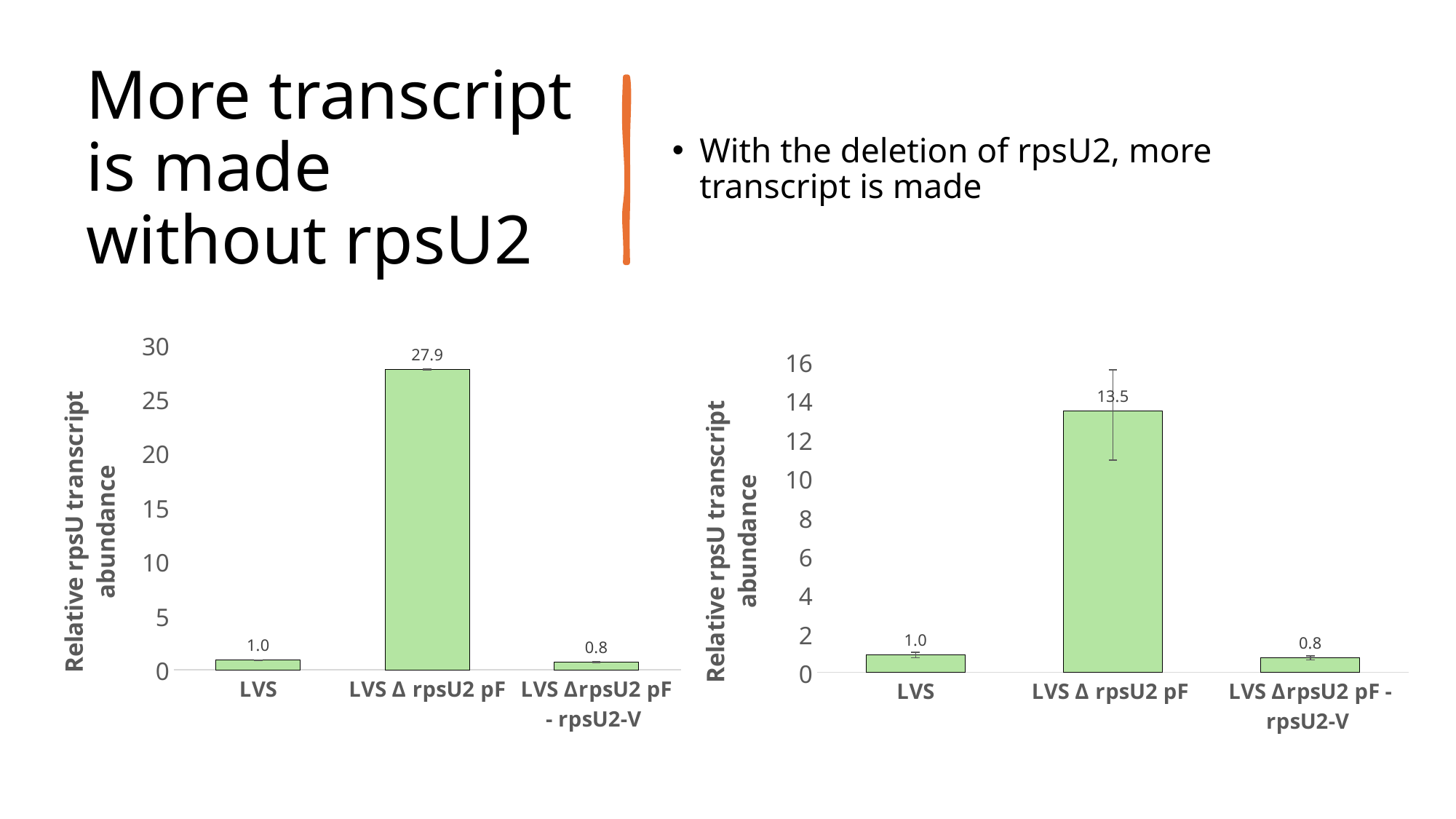
How many categories are shown in the left chart? 3 In the left chart, which is larger, the value for LVS or the value for LVS ΔrpsU2 pF - rpsU2-V? LVS In the left chart, what is the value for LVS ΔrpsU2 pF - rpsU2-V? 0.8 In the right chart, which category has the lowest relative rpsU transcript abundance? LVS ΔrpsU2 pF - rpsU2-V In the right chart, what is the relative rpsU transcript abundance for LVS Δ rpsU2 pF? 13.5 In the left chart, what is the difference between the values for LVS Δ rpsU2 pF and LVS? 26.9 In the right chart, what is the difference between the values for LVS Δ rpsU2 pF and LVS ΔrpsU2 pF - rpsU2-V? 12.7 In the left chart, what is the relative rpsU transcript abundance for LVS Δ rpsU2 pF? 27.9 In the right chart, is the value for LVS Δ rpsU2 pF greater or less than 10? greater In the left chart, which category has the highest relative rpsU transcript abundance? LVS Δ rpsU2 pF What kind of chart is the right chart? bar chart In the right chart, what is the value for LVS? 1.0